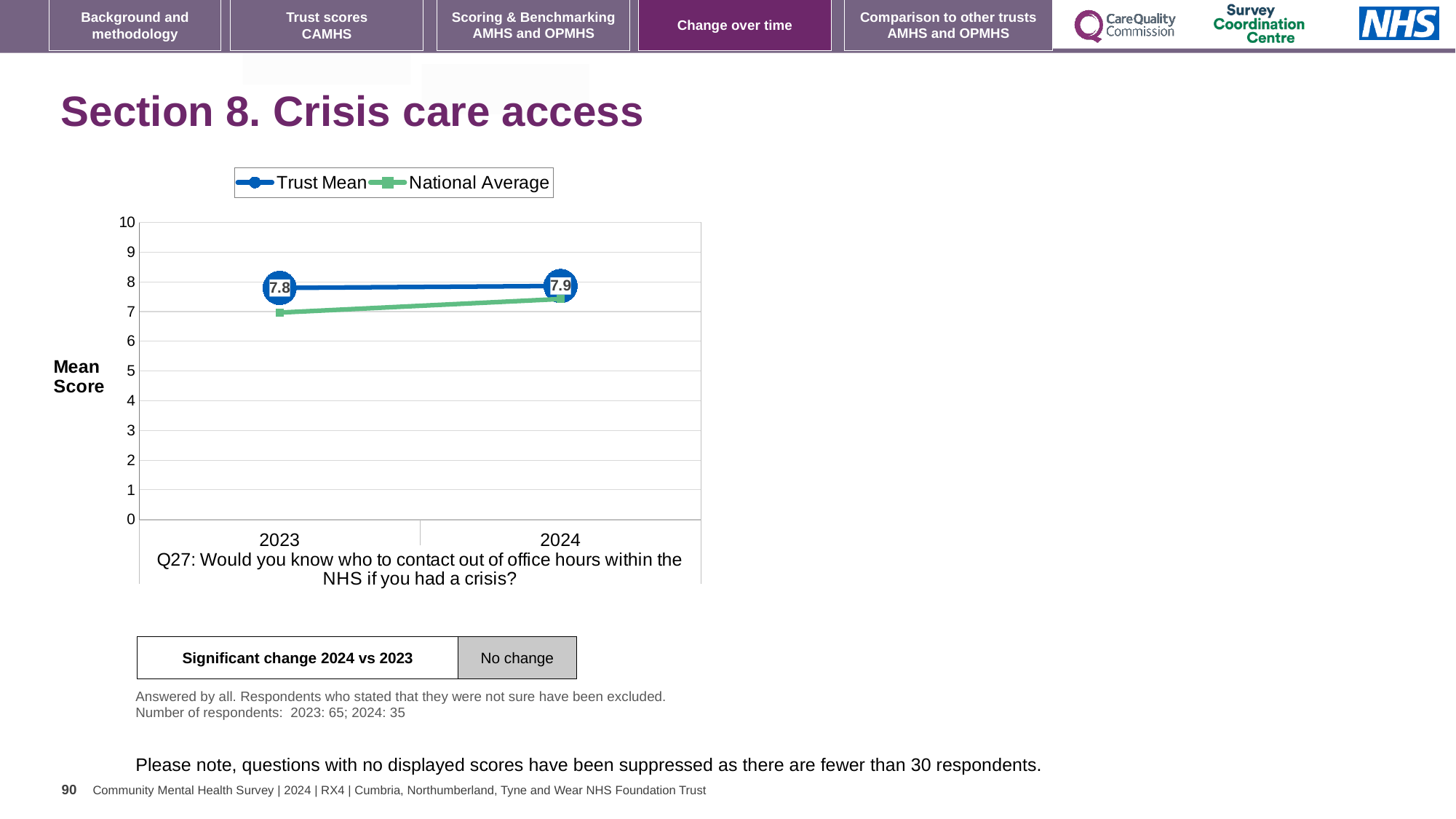
Is the National Average for 2023 greater or less than 8? less What is the label on the y axis of the chart? Mean Score Is the National Average for 2024 greater or less than 7? greater By how much did the Trust Mean change from 2023 to 2024? 0.1 In 2023, which is higher: the Trust Mean or the National Average? Trust Mean What kind of chart is shown? Line chart How many series does the legend list? 2 What is the Trust Mean score for 2023? 7.8 Which year has the higher Trust Mean, 2023 or 2024? 2024 What is the Trust Mean score for 2024? 7.9 Does the National Average rise or fall from 2023 to 2024? Rise How many years are plotted on the x axis? 2